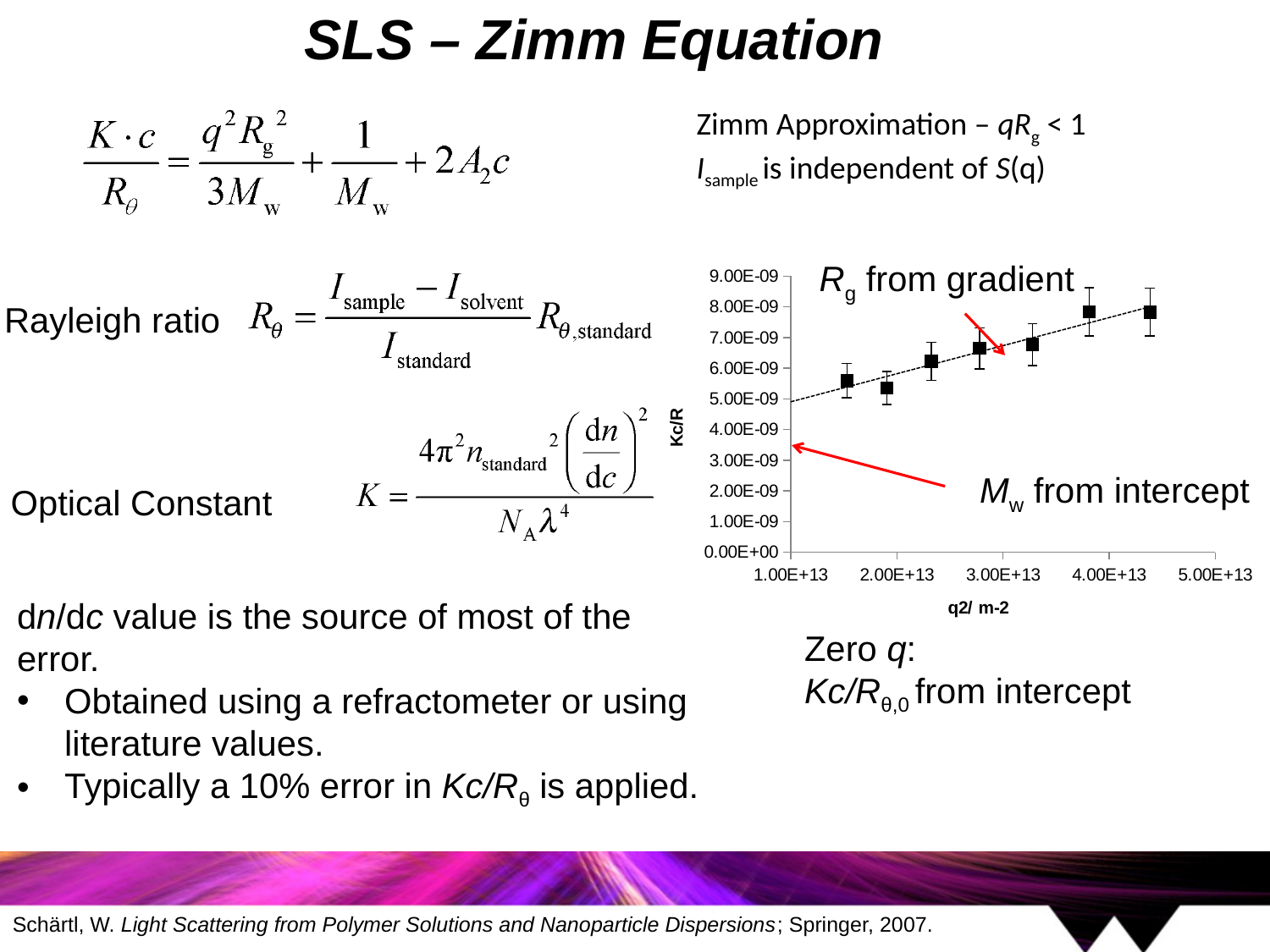
What is the title of the y axis of the chart? Kc/R Is the Kc/R value of the leftmost data point greater or less than 5.00E-09? greater Is the Kc/R value of the leftmost data point greater or less than 6.00E-09? less Which has the larger Kc/R value, the leftmost data point or the rightmost data point? the rightmost data point What is the highest value labelled on the y axis of the chart? 9.00E-09 What kind of chart is shown on the slide? scatter chart How many data points are plotted on the chart? 7 Is the Kc/R value of the rightmost data point greater or less than 9.00E-09? less What is the title of the x axis of the chart? q2/ m-2 Do the plotted Kc/R values rise or fall as q2 increases along the x axis? rise